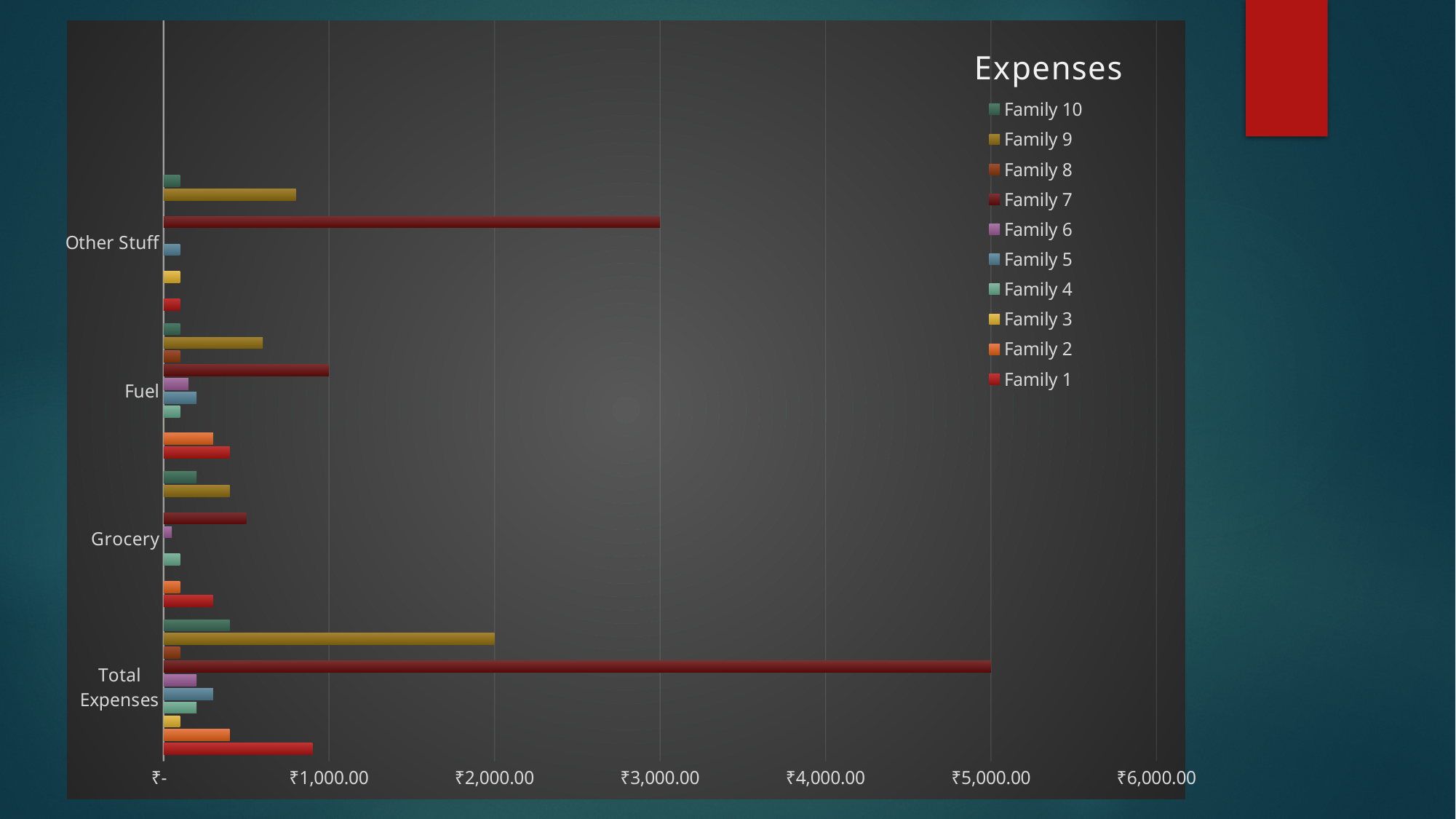
What is the value for Family 7 in the Other Stuff category? ₹3,000.00 What is the value for Family 7 in the Total Expenses category? ₹5,000.00 Is the value for Family 9 in the Other Stuff category greater or less than ₹1,000.00? less Which family has the highest value in the Total Expenses category? Family 7 How many series does the legend list? 10 What is the value for Family 7 in the Fuel category? ₹1,000.00 What is the value for Family 9 in the Total Expenses category? ₹2,000.00 Which is larger in the Total Expenses category, Family 7 or Family 9? Family 7 What is the difference between Family 7 and Family 9 in the Total Expenses category? ₹3,000.00 What kind of chart is shown on the slide? bar chart What is the title of the chart? Expenses How many categories are shown on the vertical axis? 4